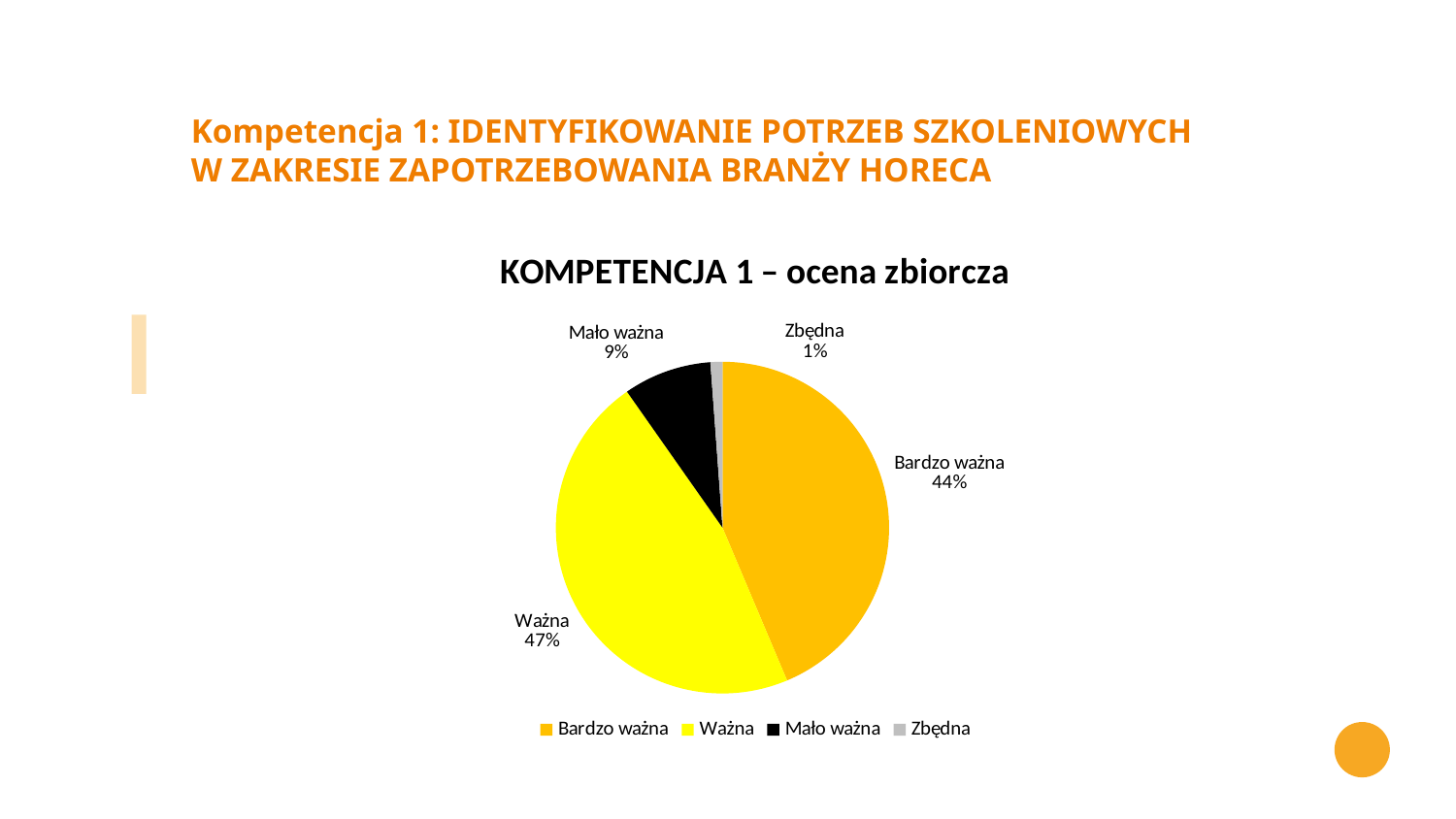
What is the title of the chart? KOMPETENCJA 1 – ocena zbiorcza Which is larger, the share for "Mało ważna" or the share for "Zbędna"? Mało ważna How many slices does the pie chart have? 4 Which category has the largest share of the pie? Ważna What percentage of the pie is labelled "Bardzo ważna"? 44% What is the difference in percentage points between "Ważna" and "Bardzo ważna"? 3 What percentage of the pie is labelled "Mało ważna"? 9% What percentage of the pie is labelled "Zbędna"? 1% What percentage of the pie is labelled "Ważna"? 47% Which colour represents "Mało ważna" in the legend? black Which category has the smallest share of the pie? Zbędna What kind of chart is shown on the slide? pie chart